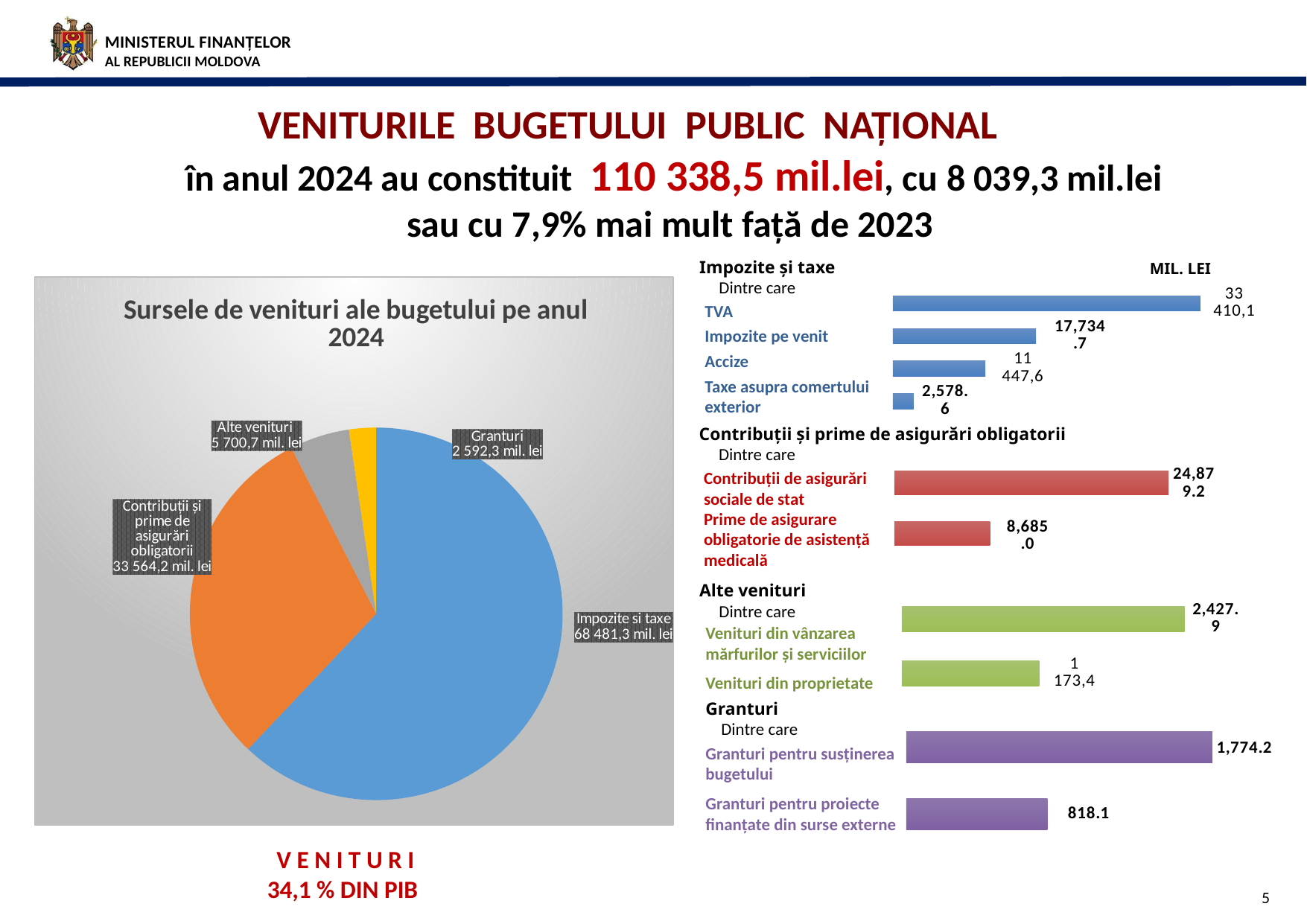
In the pie chart 'Sursele de venituri ale bugetului pe anul 2024', what is the value for Granturi? 2 592,3 mil. lei In the pie chart 'Sursele de venituri ale bugetului pe anul 2024', what is the value for Impozite si taxe? 68 481,3 mil. lei In the bar chart on the right under 'Impozite și taxe', what is the value for Accize? 11 447,6 In the bar chart on the right under 'Impozite și taxe', what is the value for TVA? 33 410,1 In the pie chart 'Sursele de venituri ale bugetului pe anul 2024', how many slices are there? 4 In the bar chart on the right under 'Impozite și taxe', which category has the lowest value? Taxe asupra comertului exterior What kind of chart is the chart titled 'Sursele de venituri ale bugetului pe anul 2024'? pie chart In the pie chart 'Sursele de venituri ale bugetului pe anul 2024', which category is the smallest? Granturi In the pie chart 'Sursele de venituri ale bugetului pe anul 2024', what is the difference between Impozite si taxe and Contribuții și prime de asigurări obligatorii? 34 917,1 mil. lei In the bar chart on the right under 'Alte venituri', what is the value for Venituri din proprietate? 1 173,4 In the bar chart on the right under 'Granturi', what is the value for Granturi pentru proiecte finanțate din surse externe? 818.1 In the bar chart on the right under 'Contribuții și prime de asigurări obligatorii', which is larger: Contribuții de asigurări sociale de stat or Prime de asigurare obligatorie de asistență medicală? Contribuții de asigurări sociale de stat